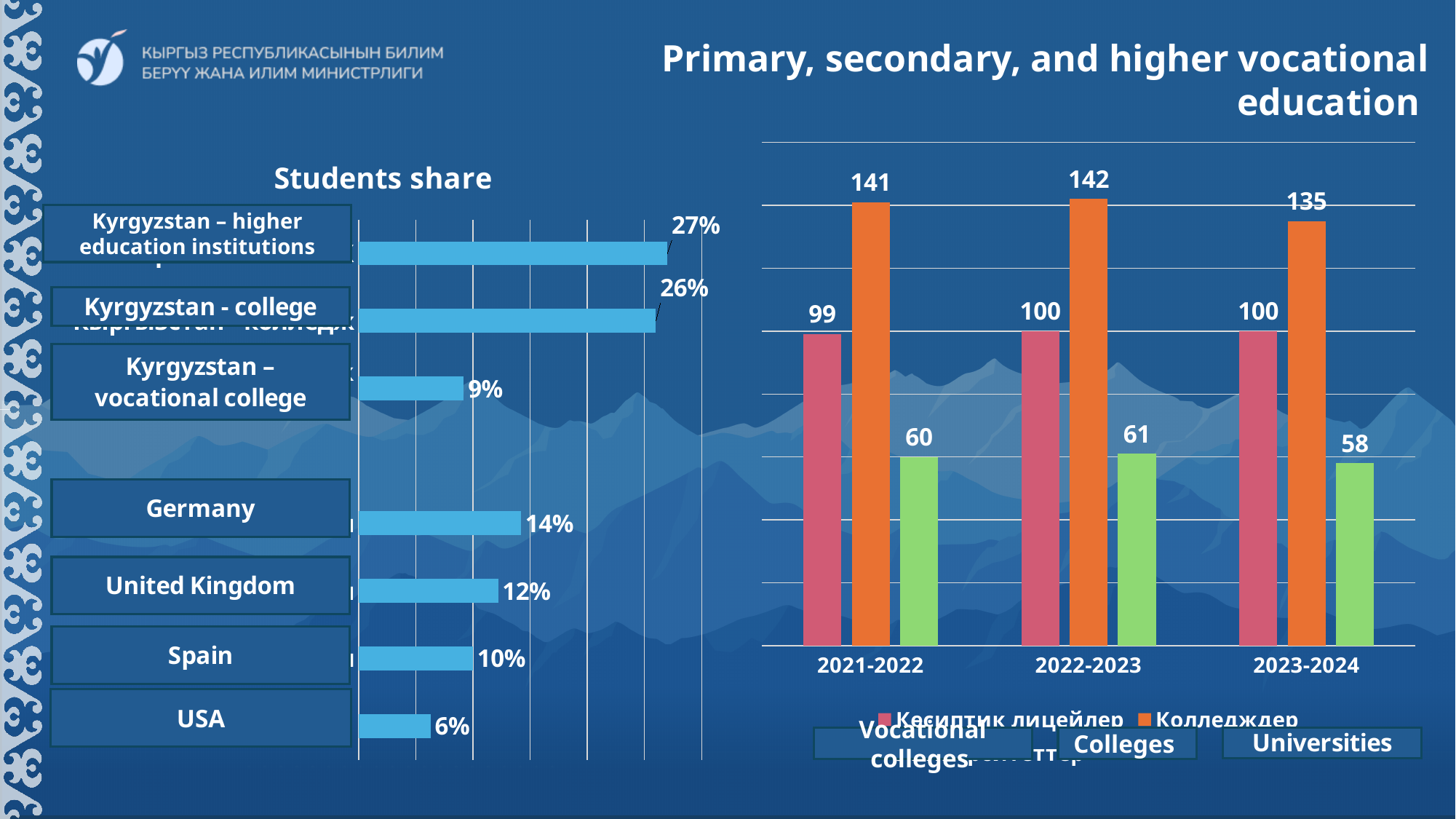
In the chart on the right, which is larger: Vocational colleges in 2021-2022 or Universities in 2021-2022? Vocational colleges in 2021-2022 In the 'Students share' chart, which category has the highest value? Kyrgyzstan – higher education institutions In the 'Students share' chart, which category has the lowest value? USA In the chart on the right, what is the value for Universities in 2023-2024? 58 In the chart on the right, what is the difference between the Colleges values for 2022-2023 and 2023-2024? 7 What kind of chart is the 'Students share' chart? Bar chart In the 'Students share' chart, what is the value for USA? 6% In the 'Students share' chart, how many categories are shown? 7 In the 'Students share' chart, what is the difference between the values for United Kingdom and Spain? 2% In the 'Students share' chart, what is the value for Germany? 14% In the chart on the right, what is the value for Colleges in 2022-2023? 142 In the chart on the right, how many series does the legend list? 3